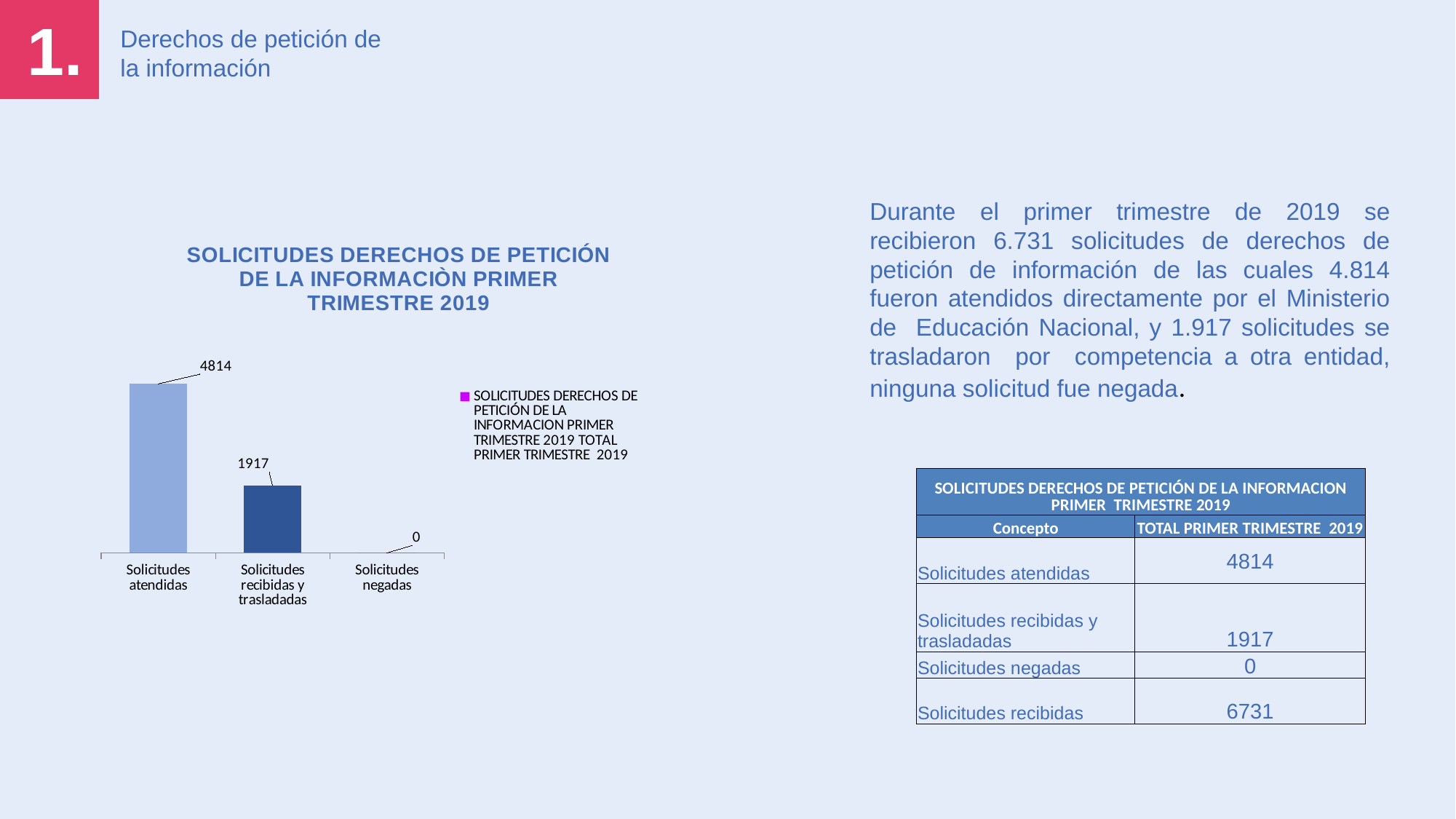
What is the difference between Solicitudes atendidas and Solicitudes recibidas y trasladadas? 2897 How many categories are shown on the chart? 3 What is the title of the chart? SOLICITUDES DERECHOS DE PETICIÓN DE LA INFORMACIÒN PRIMER TRIMESTRE 2019 Which category has the lowest value? Solicitudes negadas Which is larger, Solicitudes atendidas or Solicitudes recibidas y trasladadas? Solicitudes atendidas What is the value for Solicitudes atendidas? 4814 Do the values rise or fall from left to right across the categories? fall How many series does the legend list? 1 Which category has the highest value? Solicitudes atendidas What is the value for Solicitudes negadas? 0 What is the value for Solicitudes recibidas y trasladadas? 1917 What kind of chart is shown? bar chart